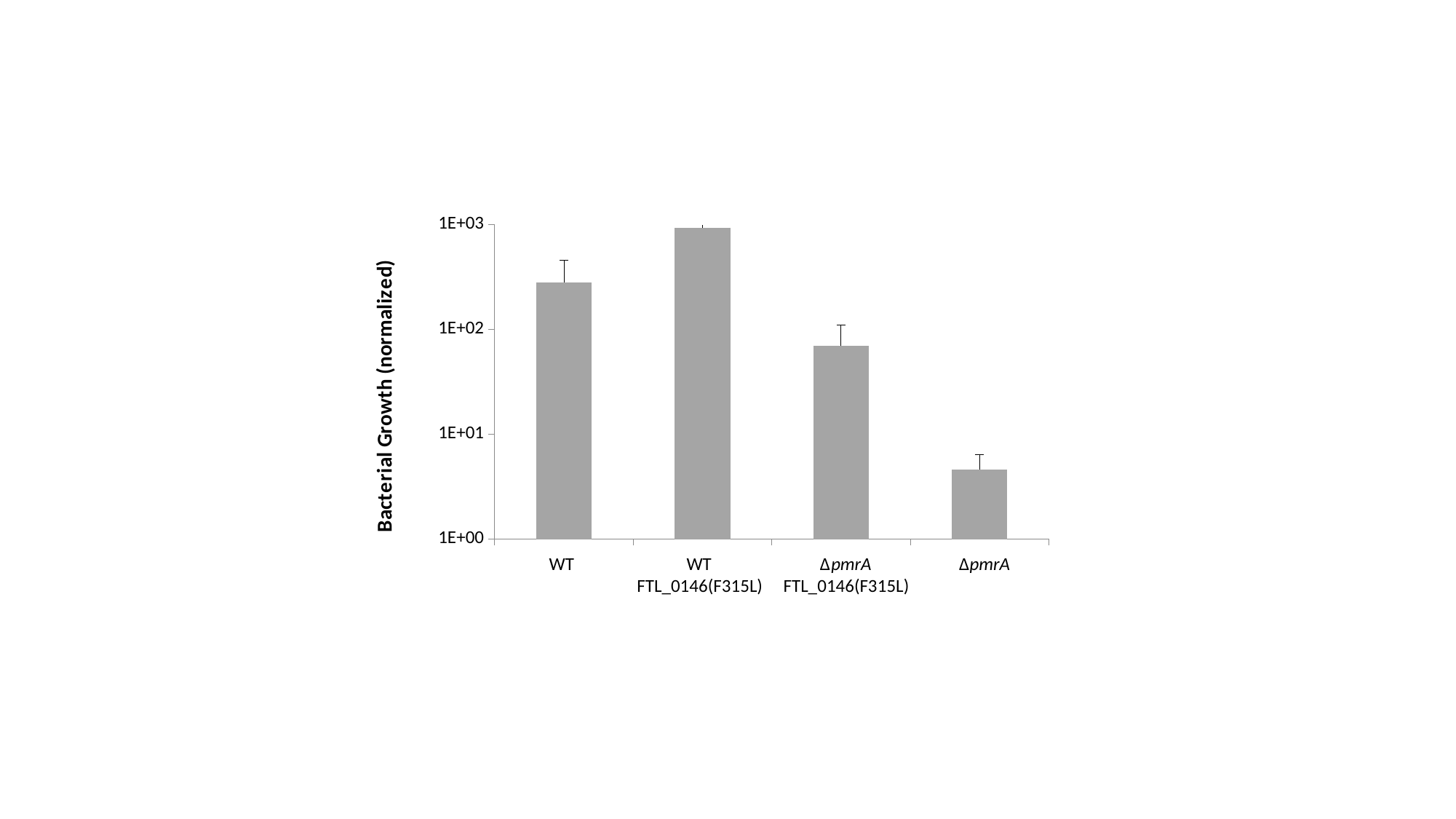
How many categories (bars) are plotted on the chart? 4 Which category has the lowest bacterial growth? ΔpmrA What is the title of the y-axis? Bacterial Growth (normalized) Which category has the highest bacterial growth? WT FTL_0146(F315L) Is the value for ΔpmrA greater or less than 1E+01? less Is the value for WT greater or less than 1E+02? greater What kind of chart is shown on the slide? bar chart Which has higher bacterial growth, WT or WT FTL_0146(F315L)? WT FTL_0146(F315L) Which has higher bacterial growth, ΔpmrA FTL_0146(F315L) or ΔpmrA? ΔpmrA FTL_0146(F315L) Which has higher bacterial growth, WT or ΔpmrA FTL_0146(F315L)? WT What is the highest tick value shown on the y-axis? 1E+03 Is the value for ΔpmrA FTL_0146(F315L) greater or less than 1E+02? less